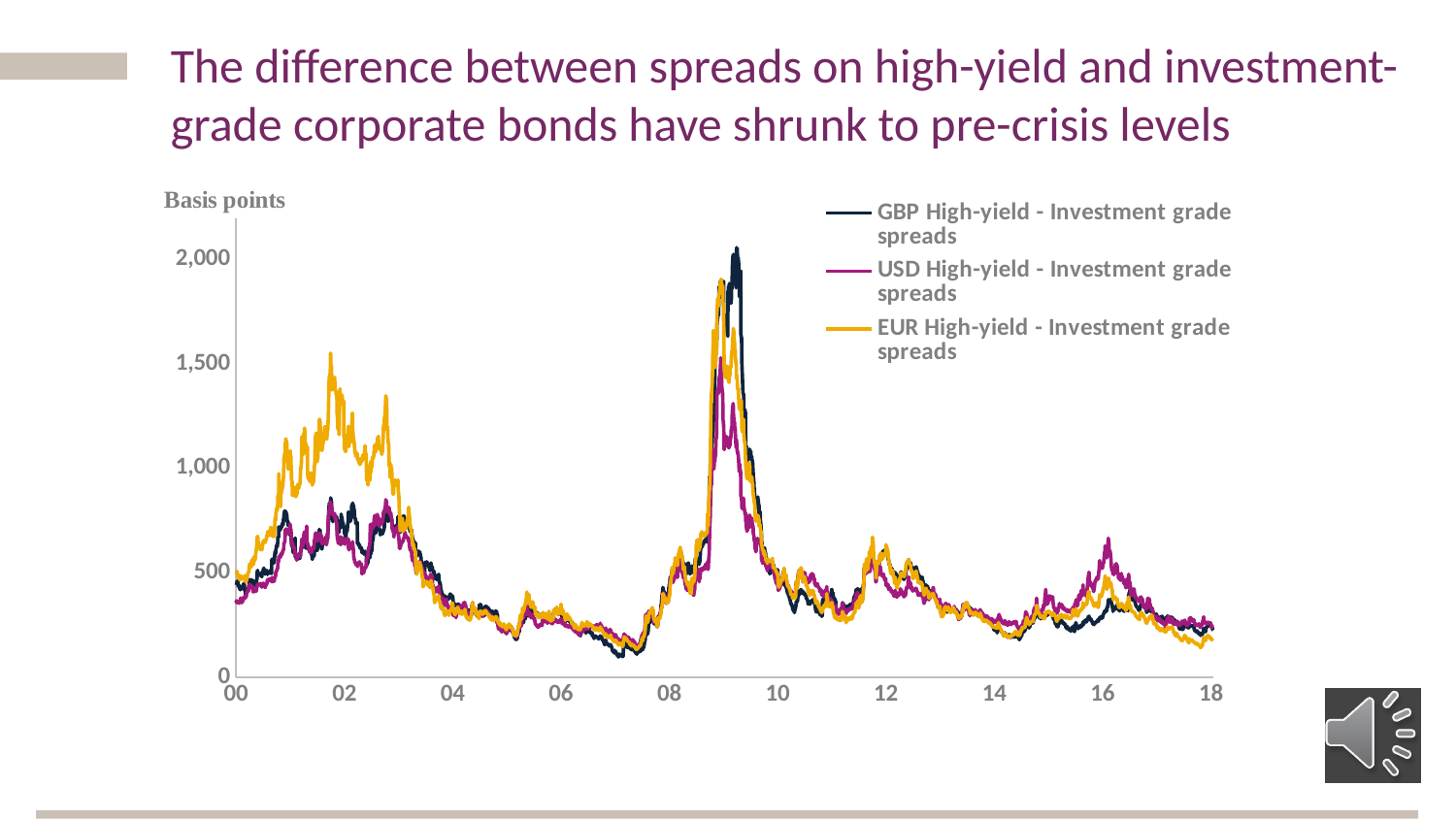
Is the peak value of the EUR High-yield - Investment grade spreads series around 2002 greater or less than 1,000? greater Which series has the highest values around 2002? EUR High-yield - Investment grade spreads What kind of chart is shown on the slide? Line chart Do the spread values rise or fall from the 2009 peak to 2018? Fall How many series does the legend list? 3 Is the value of the USD High-yield - Investment grade spreads series around 2007 greater or less than 500? less Is the value of the USD High-yield - Investment grade spreads series at the end of the chart (2018) greater or less than 500? less What unit is shown on the vertical axis of the chart? Basis points Which colour is used for the EUR High-yield - Investment grade spreads series? Yellow How many year labels are shown on the horizontal axis? 10 Around 2002, which series is higher: EUR High-yield - Investment grade spreads or GBP High-yield - Investment grade spreads? EUR High-yield - Investment grade spreads